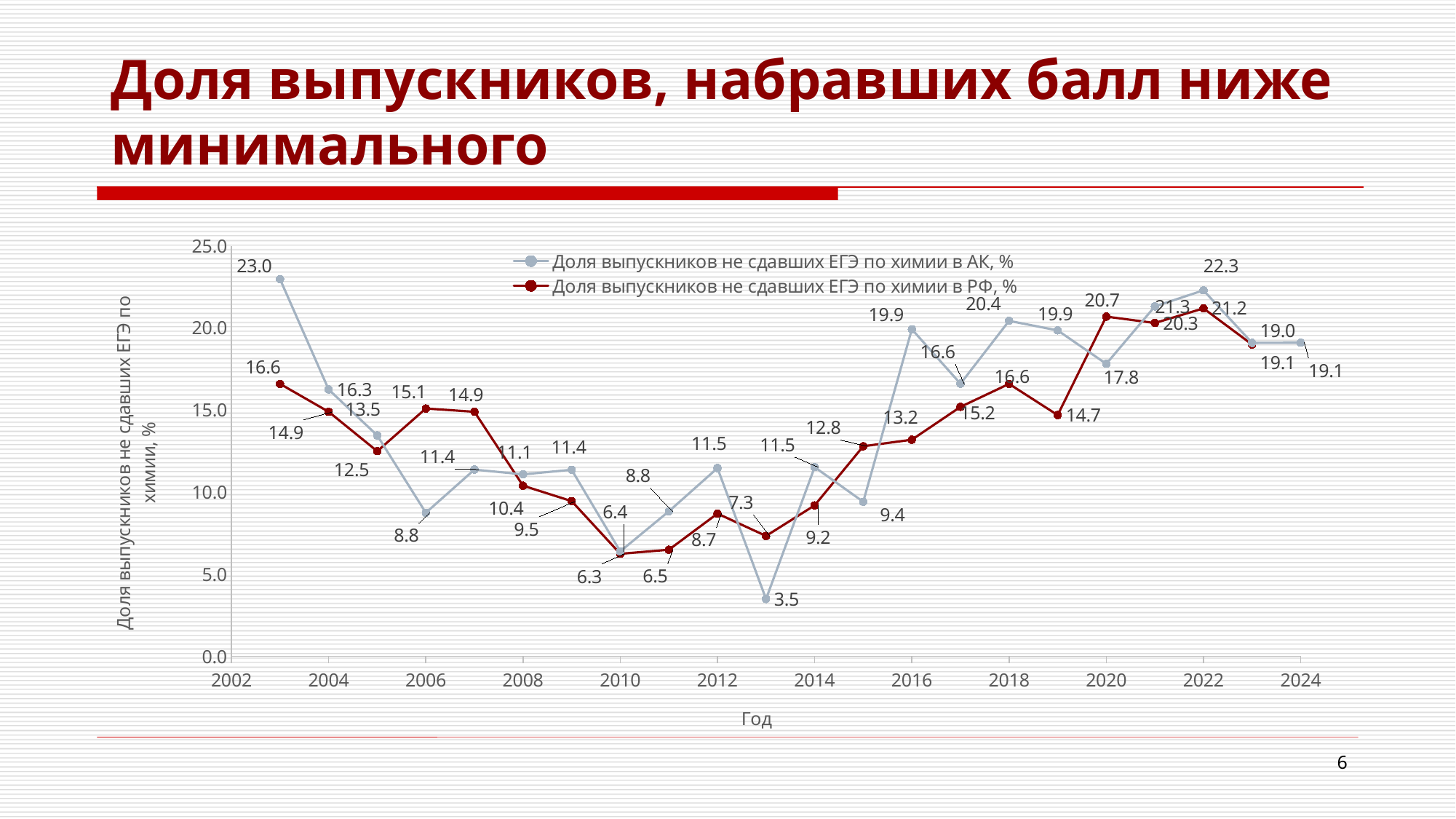
In 2016, which series has the larger value, AK or RF? AK How many series does the legend list? 2 In which year is the AK series at its lowest? 2013 What is the value for the AK series (Доля выпускников не сдавших ЕГЭ по химии в АК, %) in 2003? 23.0 What kind of chart is shown on the slide? line chart What is the value for the RF series in 2013? 7.3 Is the AK value in 2013 greater or less than 5.0? less What is the value for the RF series (Доля выпускников не сдавших ЕГЭ по химии в РФ, %) in 2020? 20.7 In which year is the RF series at its highest? 2022 In which year is the RF series at its lowest? 2010 In which year is the AK series at its highest? 2003 What is the difference between the AK value and the RF value in 2022? 1.1